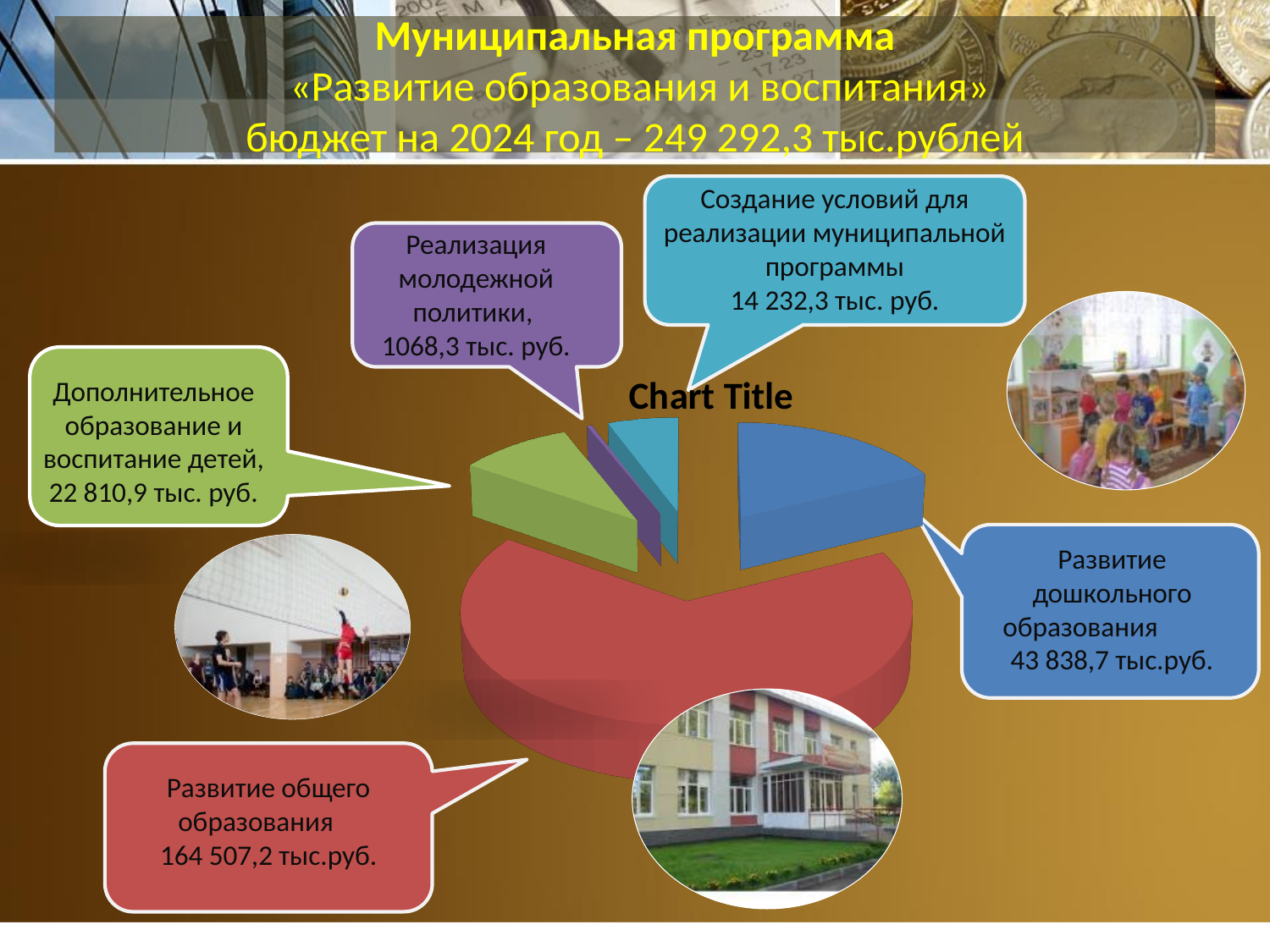
What is the value shown for «Дополнительное образование и воспитание детей»? 22 810,9 тыс. руб. What is the value shown for «Развитие дошкольного образования»? 43 838,7 тыс.руб. What is the value shown for «Реализация молодежной политики»? 1068,3 тыс. руб. What is the value shown for «Развитие общего образования»? 164 507,2 тыс.руб. What is the value shown for «Создание условий для реализации муниципальной программы»? 14 232,3 тыс. руб. What title is printed above the pie chart? Chart Title Which category has the smallest slice of the pie? Реализация молодежной политики Which is larger: «Развитие дошкольного образования» or «Дополнительное образование и воспитание детей»? Развитие дошкольного образования What is the difference between «Развитие дошкольного образования» and «Создание условий для реализации муниципальной программы»? 29 606,4 тыс. руб. What kind of chart is shown on the slide? pie chart Which category has the largest slice of the pie? Развитие общего образования How many slices does the pie chart have? 5